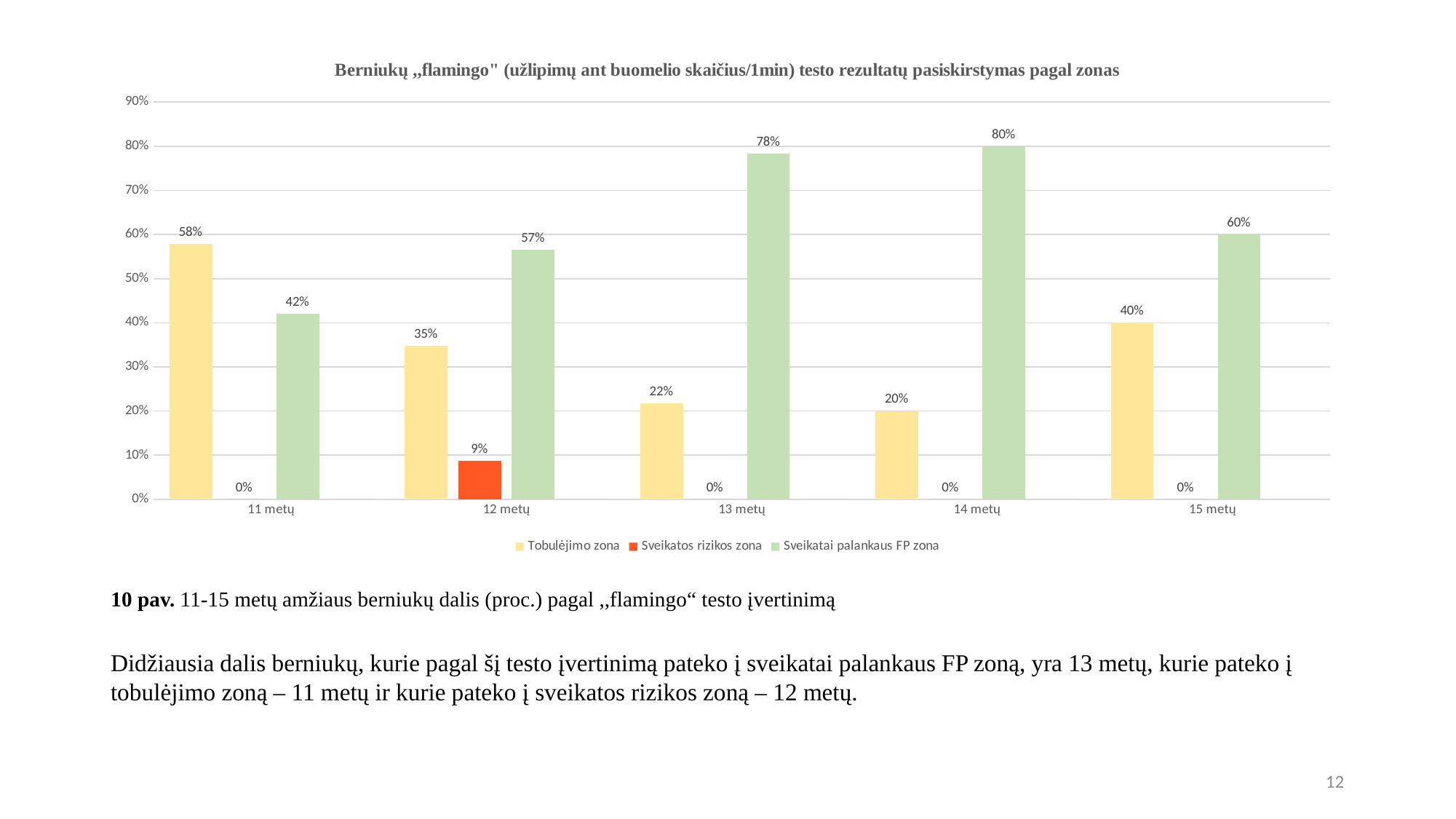
Which series is shown in orange in the legend? Sveikatos rizikos zona Which age group has the highest value for Sveikatai palankaus FP zona? 14 metų How many age groups are shown on the x axis? 5 What is the value for Sveikatos rizikos zona at 12 metų? 9% What is the value for Tobulėjimo zona at 11 metų? 58% Which age group has the lowest value for Tobulėjimo zona? 14 metų What is the difference between the Sveikatai palankaus FP zona values at 14 metų and 15 metų? 20% What kind of chart is shown on the slide? Bar chart Does the Sveikatai palankaus FP zona value rise or fall from 11 metų to 13 metų? Rise What is the value for Sveikatai palankaus FP zona at 13 metų? 78% How many series does the legend list? 3 Which is larger: Tobulėjimo zona at 12 metų or Sveikatai palankaus FP zona at 12 metų? Sveikatai palankaus FP zona at 12 metų